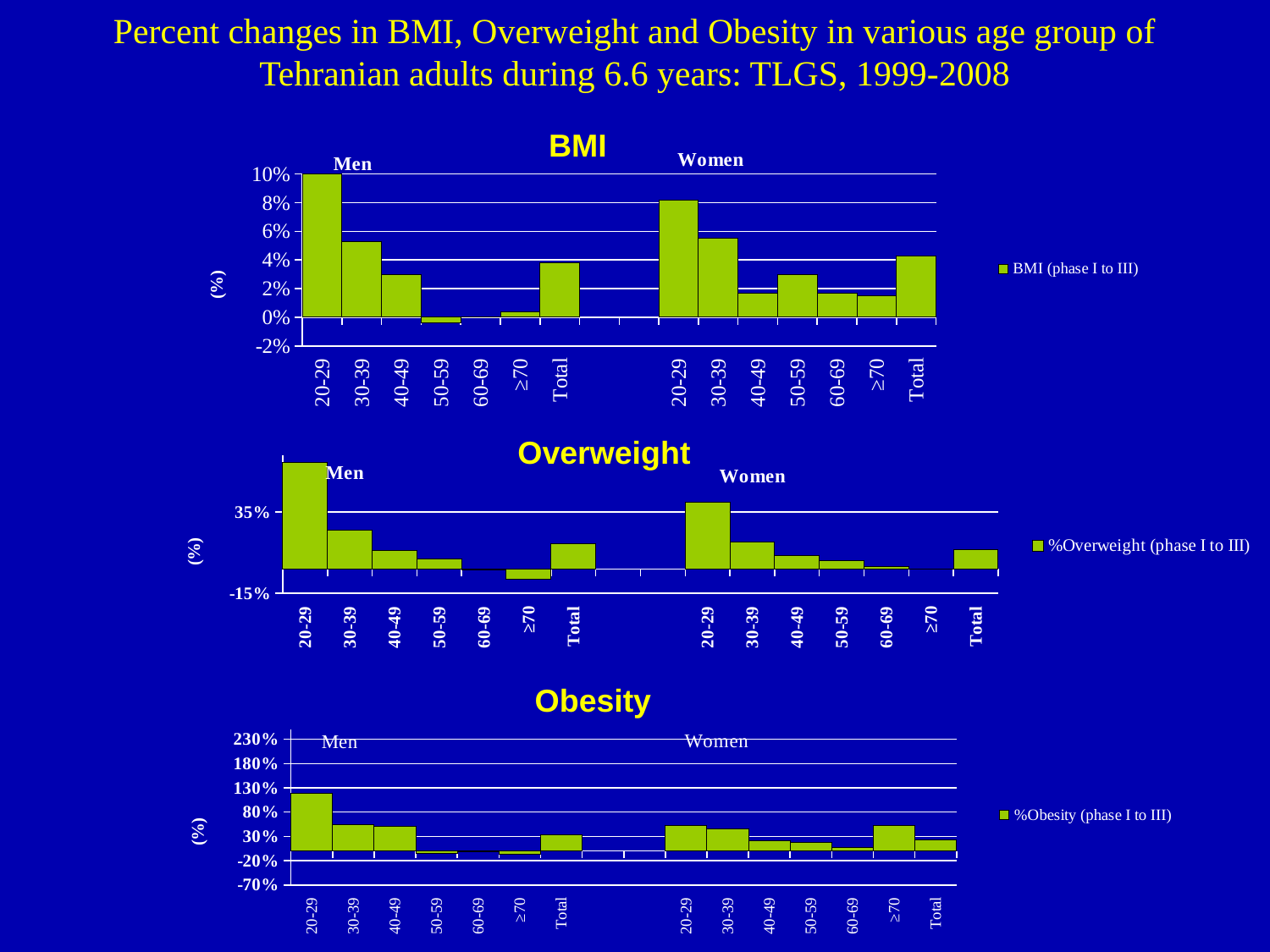
In the Overweight chart, which age group among men has the highest value? 20-29 In the BMI chart, which age group among men has the highest value? 20-29 In the Overweight chart, is the value for men aged 20-29 greater or less than 35%? greater What kind of chart is the BMI chart? bar chart In the Obesity chart, which is larger: the value for men aged 20-29 or women aged 20-29? men aged 20-29 How many series does the legend of the Obesity chart list? 1 In the Overweight chart, which age group among men has the lowest value? ≥70 In the BMI chart, is the value for men aged 40-49 greater or less than 4%? less In the BMI chart, which age group among men has the lowest value? 50-59 In the BMI chart, is the value for women aged 20-29 greater or less than 6%? greater In the BMI chart, do the values for men fall or rise from the 20-29 group to the 60-69 group? fall